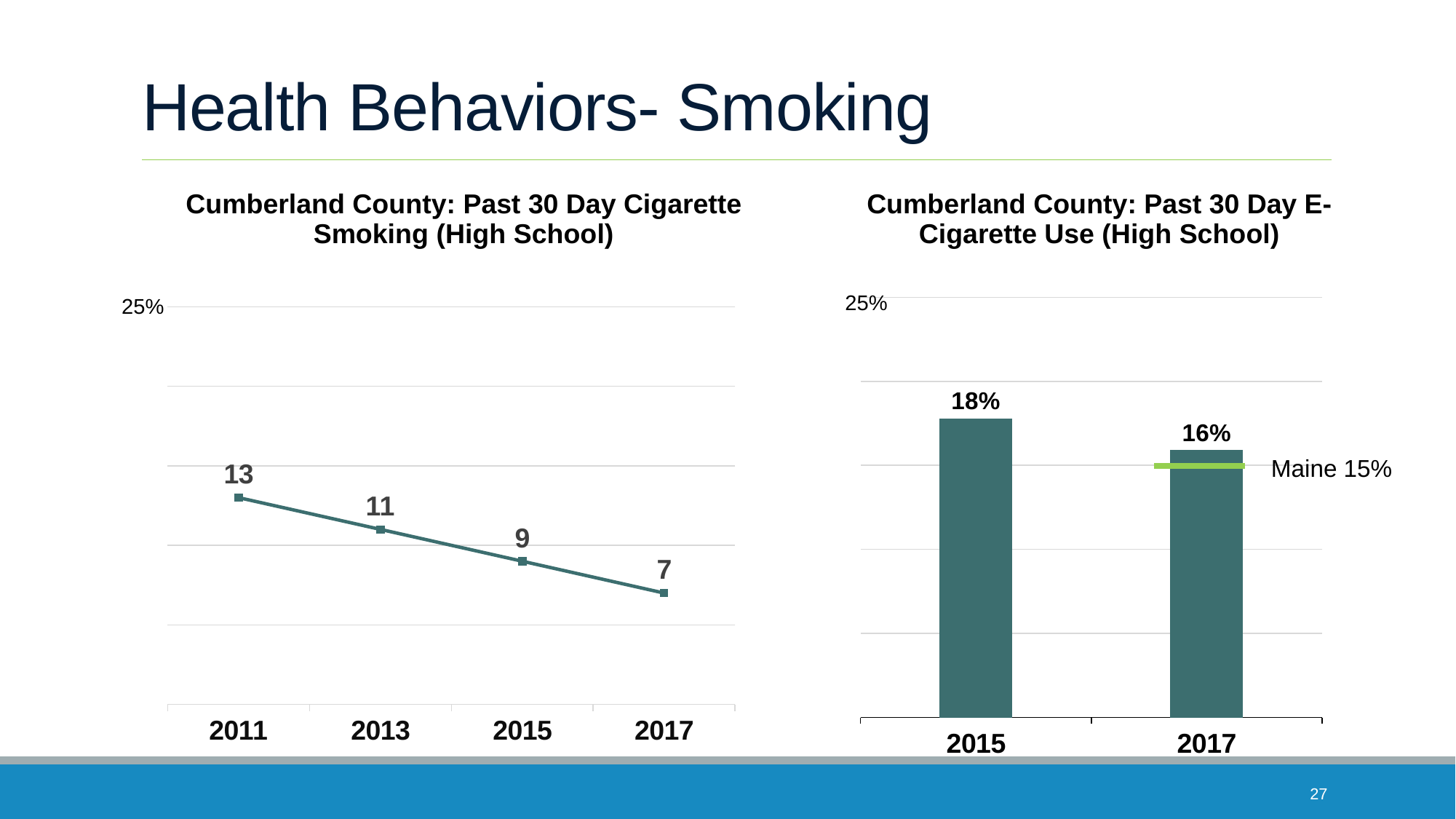
In the 'Cumberland County: Past 30 Day Cigarette Smoking (High School)' chart, what is the value for 2017? 7 What kind of chart is 'Cumberland County: Past 30 Day E-Cigarette Use (High School)'? bar chart In the 'Cumberland County: Past 30 Day Cigarette Smoking (High School)' chart, what is the difference between the 2011 and 2017 values? 6 In the 'Cumberland County: Past 30 Day Cigarette Smoking (High School)' chart, how many years are plotted? 4 In the 'Cumberland County: Past 30 Day E-Cigarette Use (High School)' chart, what is the value for 2015? 18% In the 'Cumberland County: Past 30 Day E-Cigarette Use (High School)' chart, which year has the higher value, 2015 or 2017? 2015 In the 'Cumberland County: Past 30 Day Cigarette Smoking (High School)' chart, do the values rise or fall from 2011 to 2017? fall What kind of chart is 'Cumberland County: Past 30 Day Cigarette Smoking (High School)'? line chart In the 'Cumberland County: Past 30 Day E-Cigarette Use (High School)' chart, what is the value for 2017? 16% In the 'Cumberland County: Past 30 Day E-Cigarette Use (High School)' chart, what Maine value is marked by the green line? 15% In the 'Cumberland County: Past 30 Day Cigarette Smoking (High School)' chart, which year has the lowest value? 2017 In the 'Cumberland County: Past 30 Day Cigarette Smoking (High School)' chart, what is the value for 2011? 13